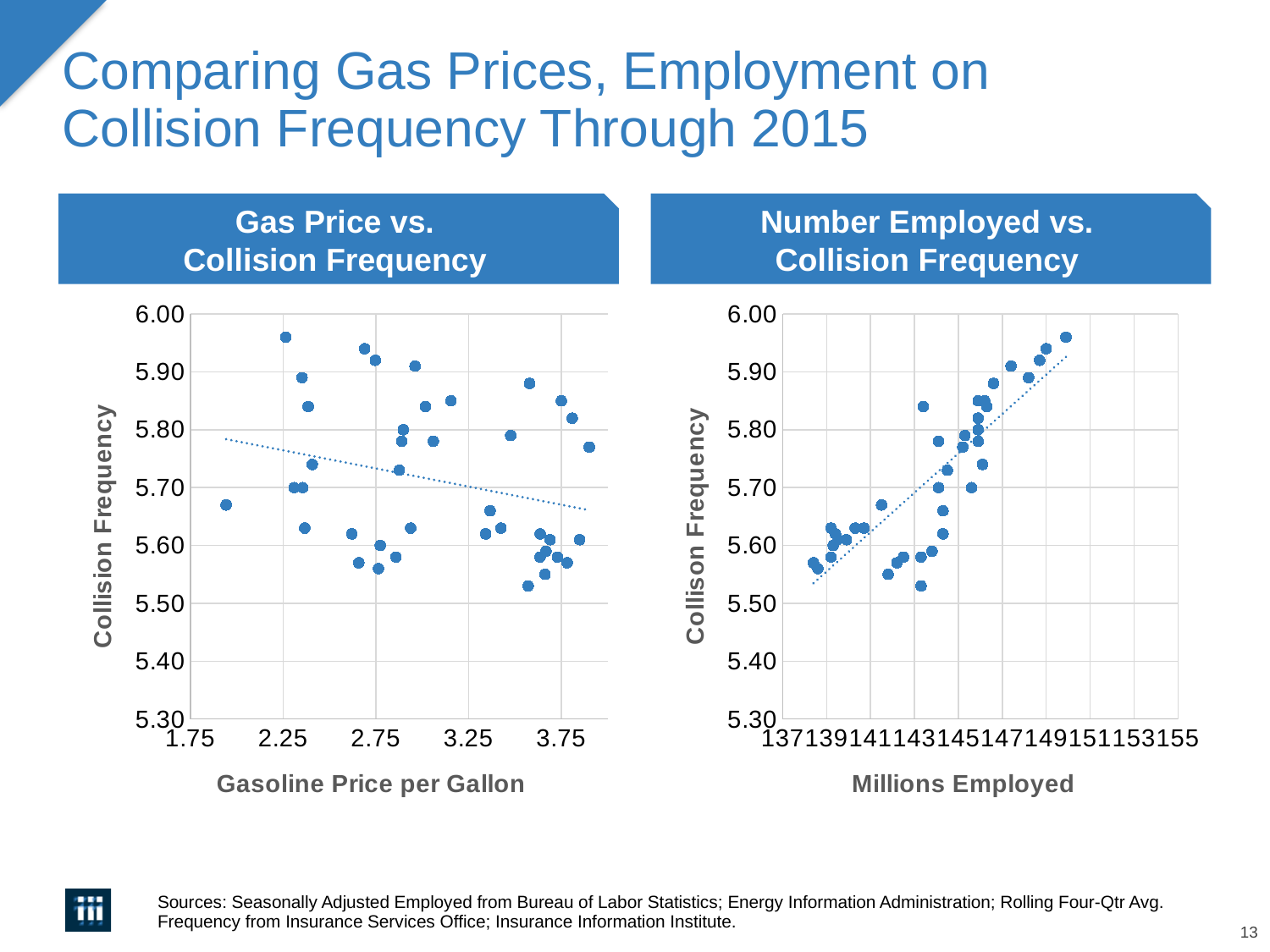
In the 'Gas Price vs. Collision Frequency' chart, does the dotted trend line rise or fall as gasoline price increases? fall In the 'Number Employed vs. Collision Frequency' chart, does the dotted trend line rise or fall as millions employed increases? rise What is the x-axis title of the 'Gas Price vs. Collision Frequency' chart? Gasoline Price per Gallon In the 'Number Employed vs. Collision Frequency' chart, is the largest millions-employed value plotted greater or less than 151? less In the 'Gas Price vs. Collision Frequency' chart, is the lowest gasoline price plotted greater or less than 2.25? less In the 'Gas Price vs. Collision Frequency' chart, is the lowest collision frequency plotted greater or less than 5.60? less What kind of chart is the 'Gas Price vs. Collision Frequency' chart? scatter chart How many charts are shown on the slide? 2 What kind of chart is the 'Number Employed vs. Collision Frequency' chart? scatter chart What is the x-axis title of the 'Number Employed vs. Collision Frequency' chart? Millions Employed